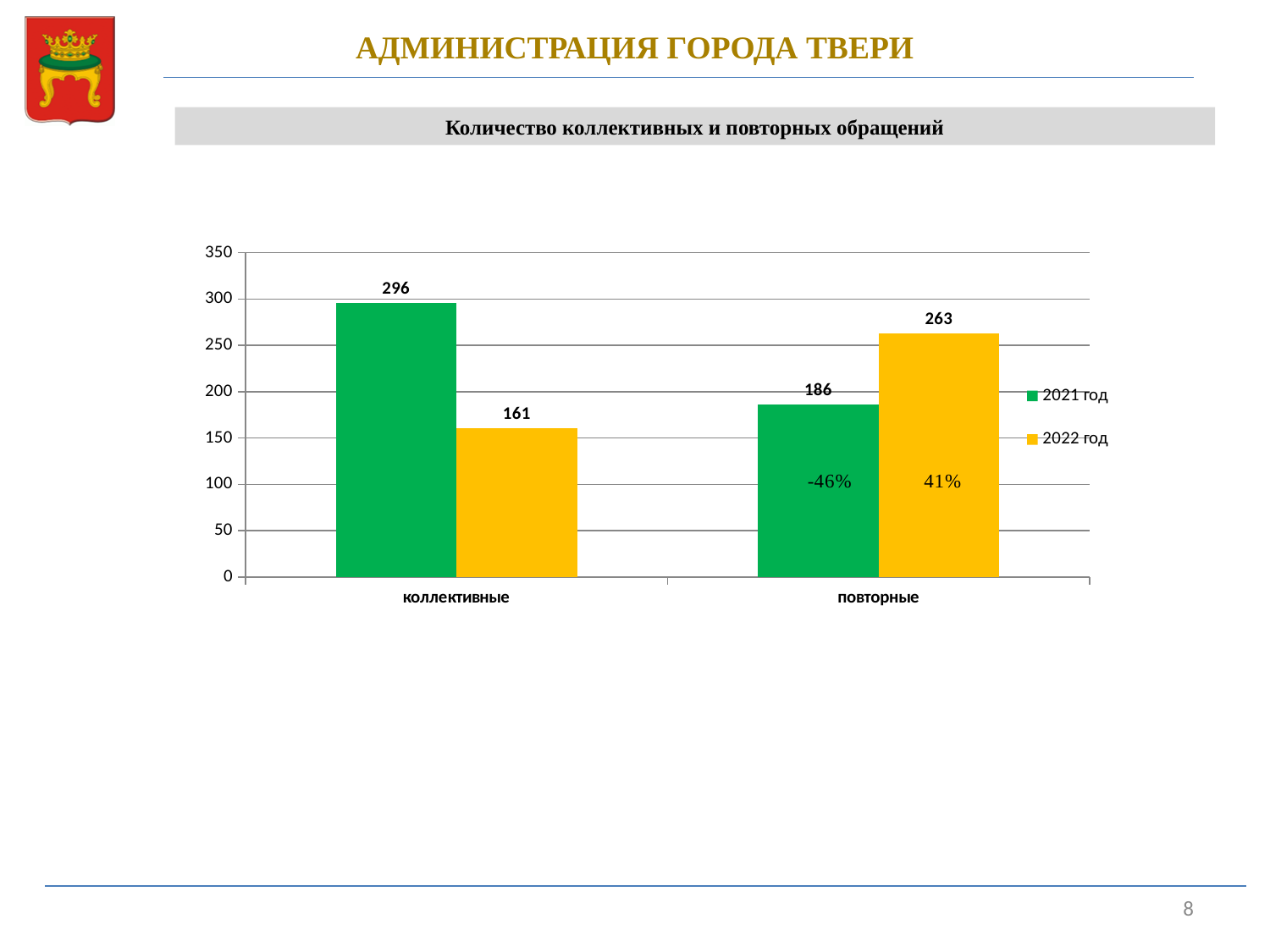
What is the difference between the 2021 год and 2022 год values for коллективные? 135 What is the value for повторные in 2021 год? 186 What is the title of the chart? Количество коллективных и повторных обращений What is the value for повторные in 2022 год? 263 How many series does the legend list? 2 What is the value for коллективные in 2021 год? 296 What is the value for коллективные in 2022 год? 161 Which category has the lowest value in the 2022 год series? коллективные Which is larger for повторные: the 2021 год value or the 2022 год value? 2022 год What is the difference between the 2022 год and 2021 год values for повторные? 77 What kind of chart is shown on the slide? bar chart Which category has the highest value in the 2021 год series? коллективные